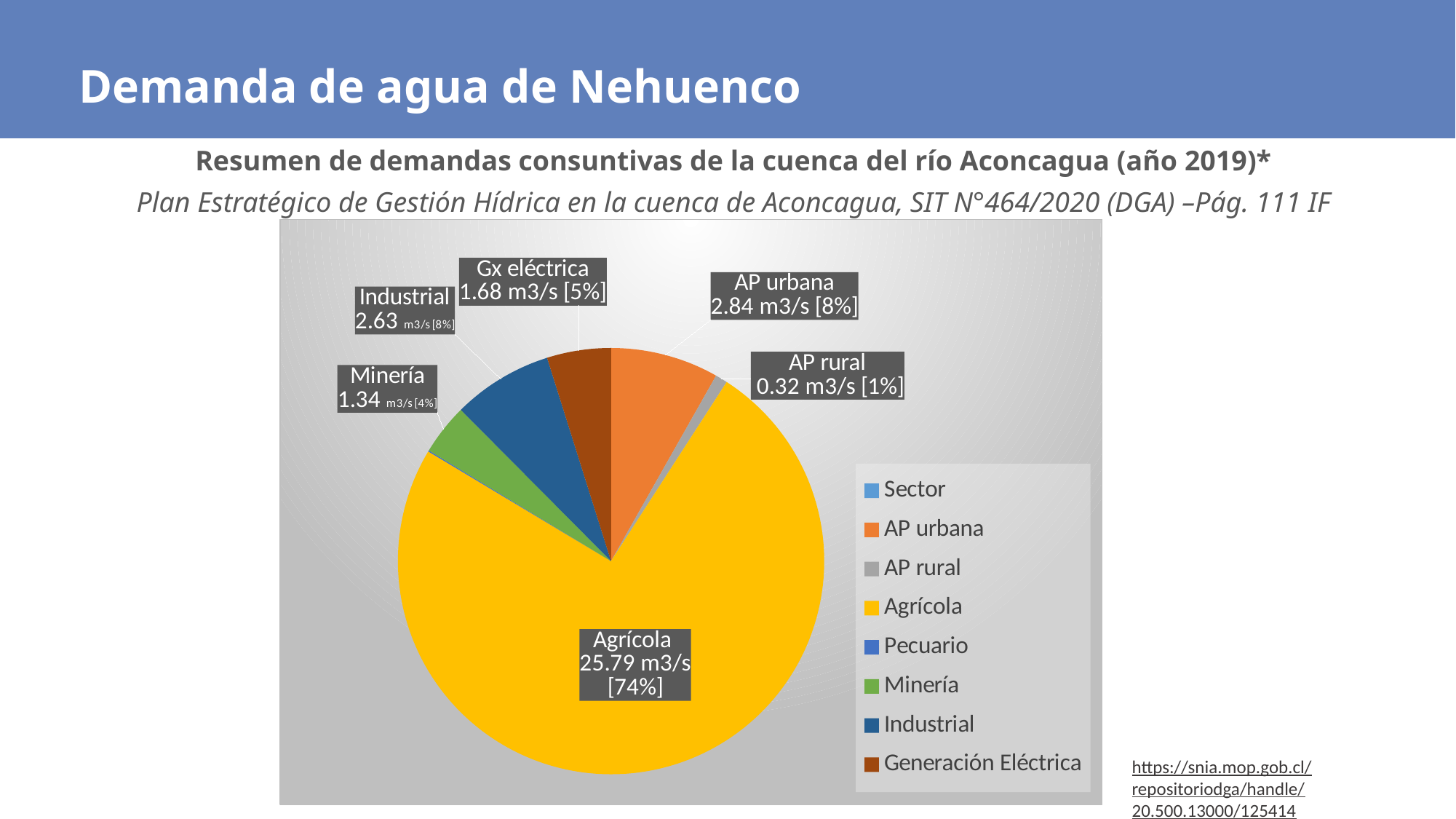
What is the value shown for Gx eléctrica? 1.68 m3/s Which sector has the largest slice of the pie? Agrícola What is the difference between the AP urbana value and the AP rural value? 2.52 m3/s Which is larger, the value for Industrial or the value for Minería? Industrial What percentage share of the pie does Agrícola have? 74% What percentage share of the pie does Minería have? 4% How many entries does the legend list? 8 What is the value shown for AP urbana? 2.84 m3/s Which labelled sector has the smallest slice of the pie? AP rural What kind of chart is shown on the slide? Pie chart What is the value shown for AP rural? 0.32 m3/s What is the value shown for Agrícola? 25.79 m3/s